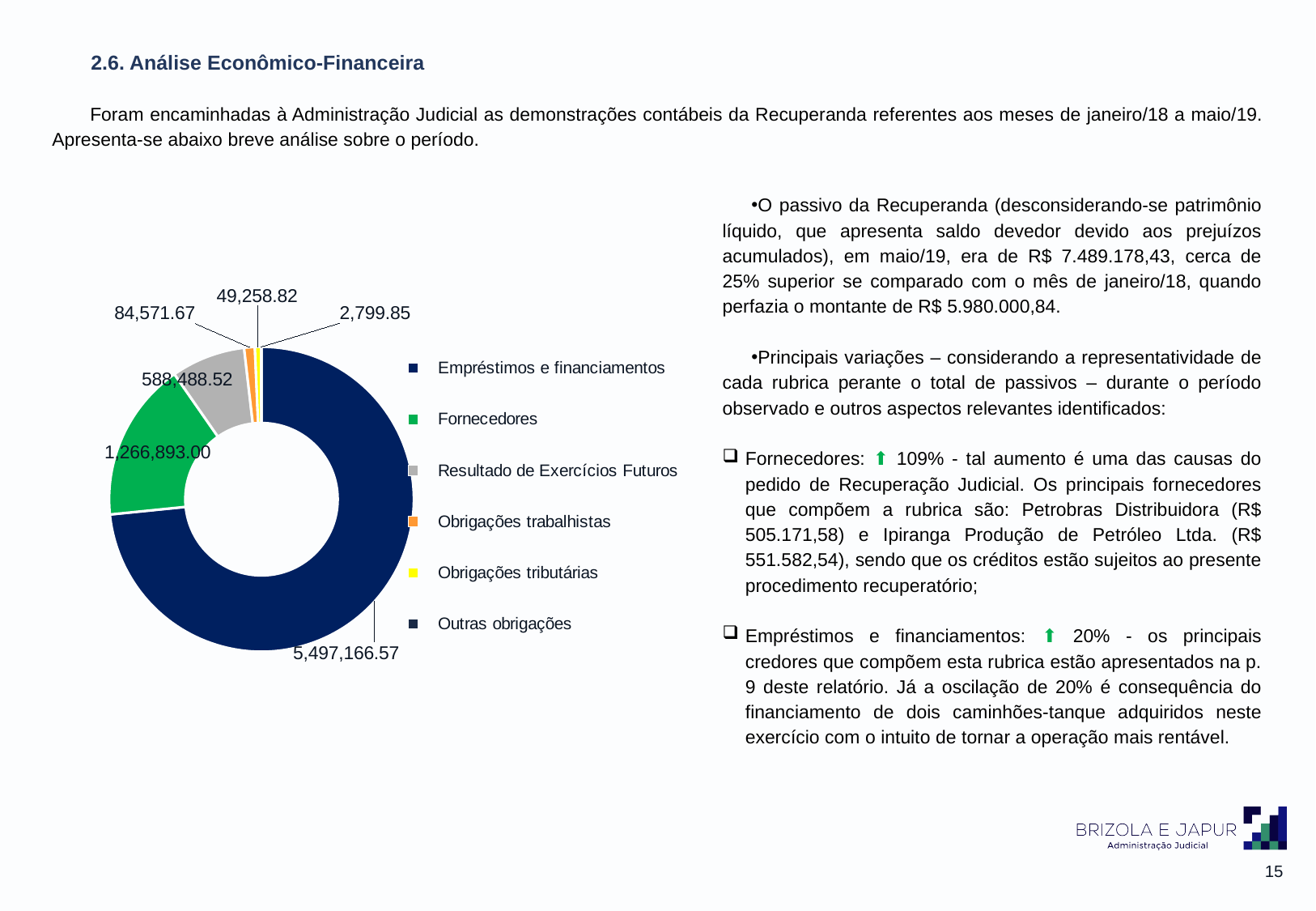
What type of chart is shown on the slide? Doughnut chart What is the value for Obrigações tributárias? 49,258.82 What is the value for Fornecedores? 1,266,893.00 What is the value for Resultado de Exercícios Futuros? 588,488.52 What colour is the Fornecedores slice? Green Which is larger, Obrigações trabalhistas or Obrigações tributárias? Obrigações trabalhistas What is the value for Empréstimos e financiamentos? 5,497,166.57 What is the difference between Empréstimos e financiamentos and Fornecedores? 4,230,273.57 Which category has the smallest value? Outras obrigações Which category has the largest value? Empréstimos e financiamentos How many categories does the legend list? 6 What is the value for Obrigações trabalhistas? 84,571.67